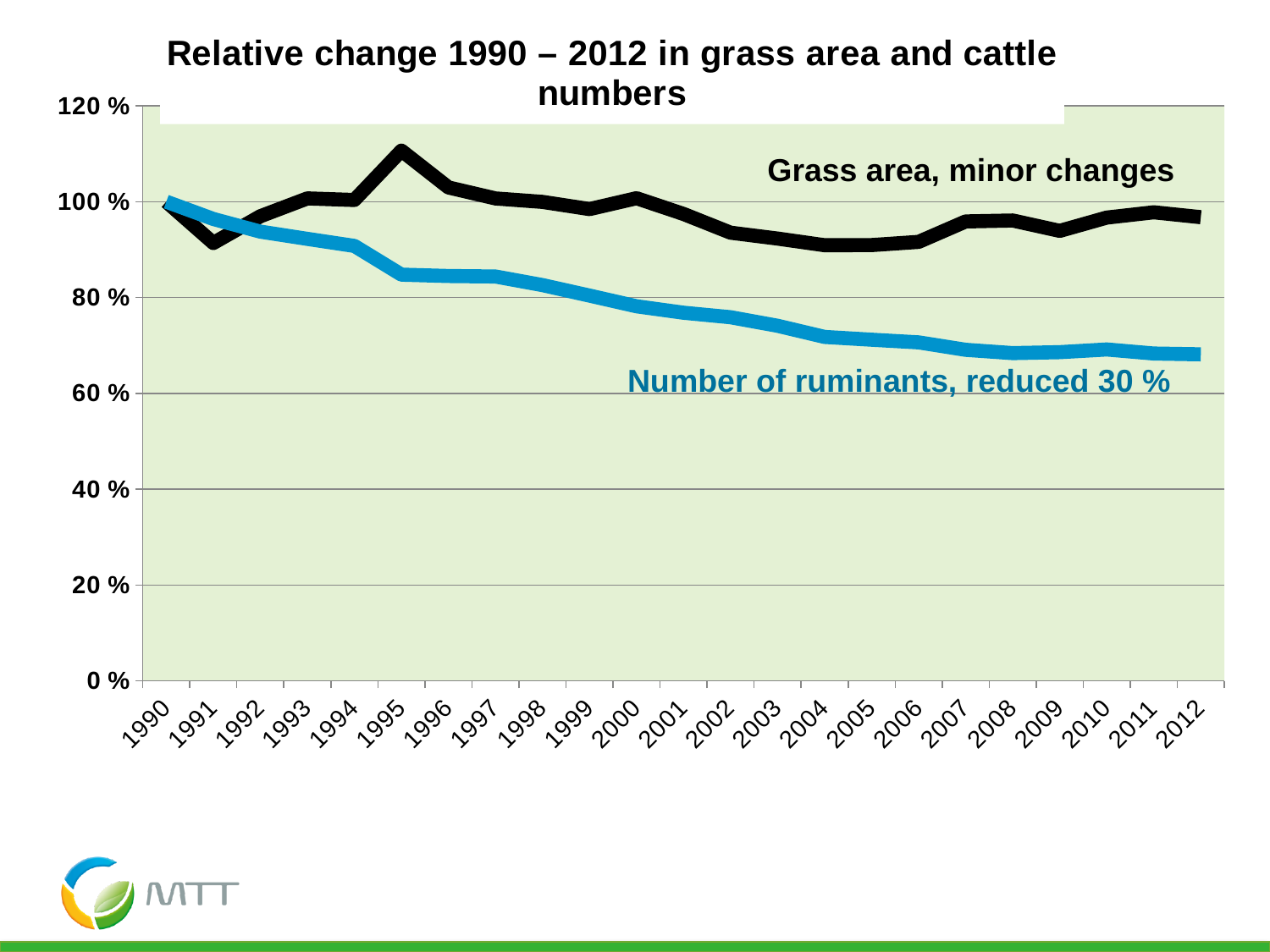
How many series are plotted on the chart? 2 According to the label on the chart, by how much was the number of ruminants reduced? 30 % In 2012, which series has the larger value, Grass area or Number of ruminants? Grass area Is the value for Number of ruminants in 2012 greater or less than 80 %? less What kind of chart is shown on the slide? line chart Is the value for Grass area in 2004 greater or less than 80 %? greater How many years are shown along the x axis? 23 What is the title of the chart? Relative change 1990 – 2012 in grass area and cattle numbers Is the value for Grass area in 1995 greater or less than 100 %? greater Does the Number of ruminants series rise or fall from 1990 to 2012? fall In which year does the Grass area series reach its highest value? 1995